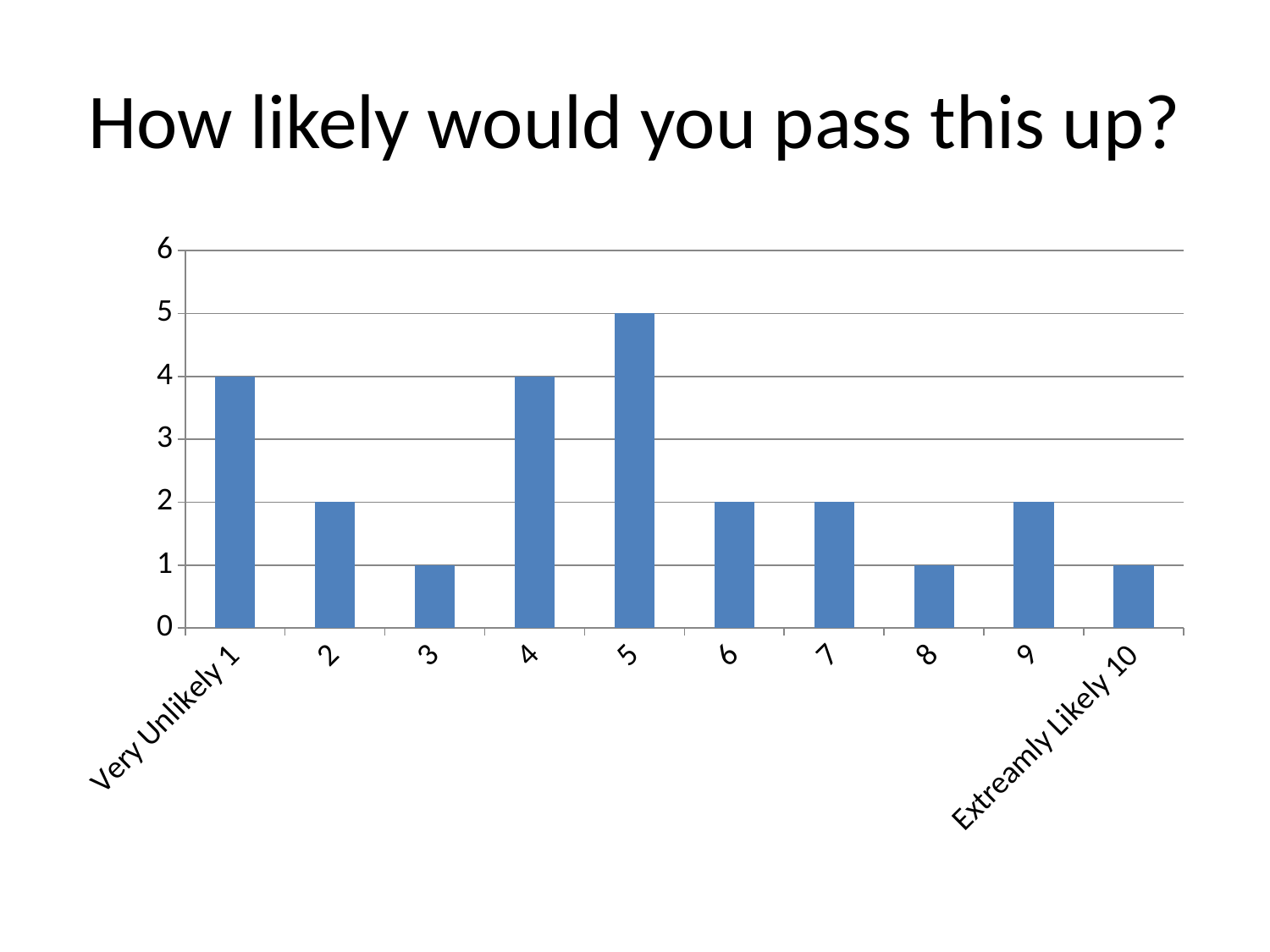
What is the value for "Very Unlikely 1"? 4 Which is larger, the value for category 4 or the value for category 6? 4 What is the highest value shown on the y axis? 6 Is the value for category 5 greater or less than 4? greater What kind of chart is shown on the slide? bar chart What is the difference between the values for category 5 and category 2? 3 What is the value for "Extreamly Likely 10"? 1 Which category has the highest value? 5 What is the value for category 9? 2 How many categories are shown on the x axis? 10 What is the value for category 5? 5 What is the title of the slide? How likely would you pass this up?